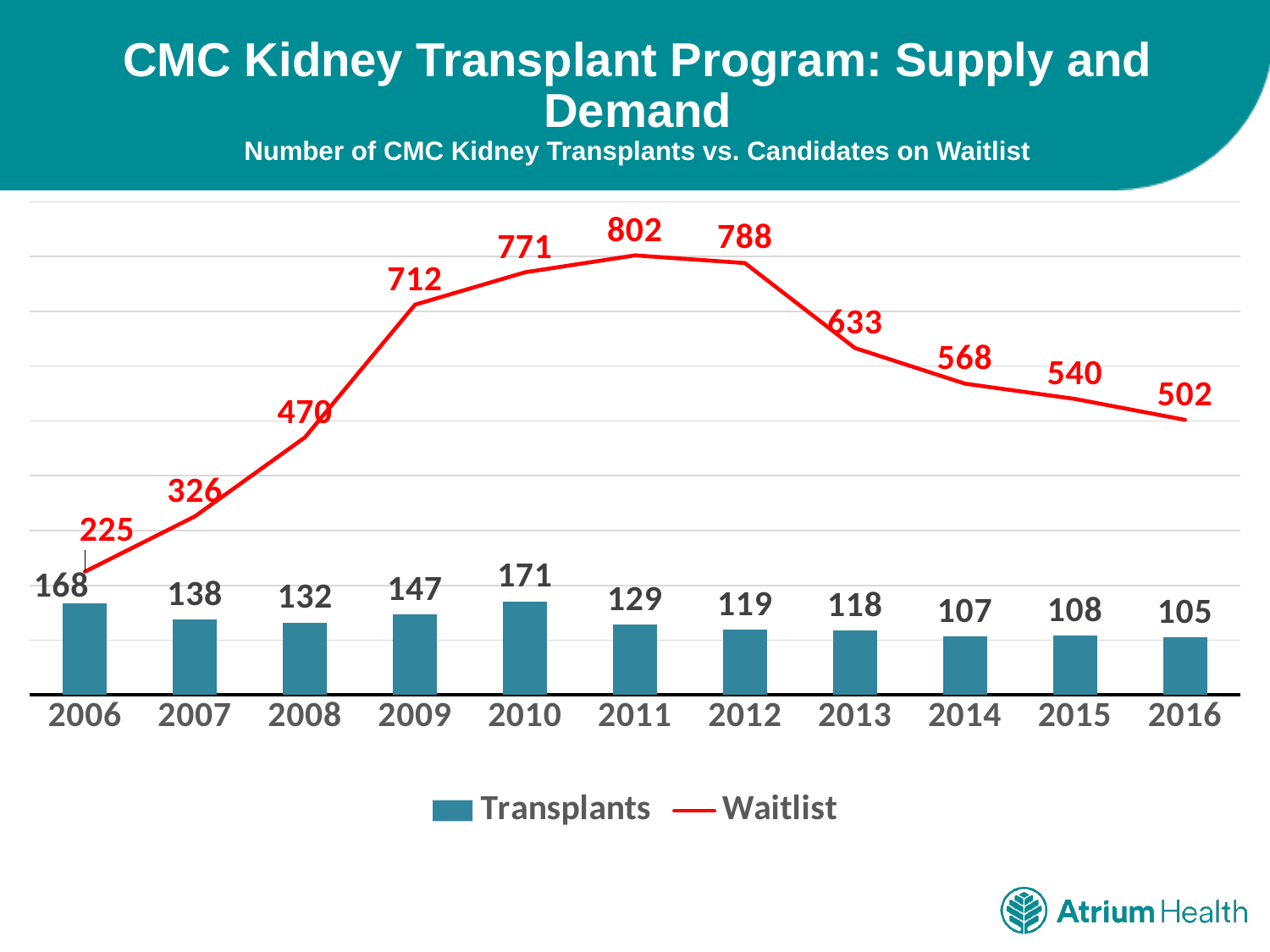
What was the waitlist value in 2016? 502 What colour is the Waitlist line? Red Which year had the lowest waitlist value? 2006 How many candidates were on the waitlist in 2011? 802 How many years are shown on the x axis? 11 How many series does the legend list? 2 How many kidney transplants were performed in 2010? 171 Which is larger, the number of transplants in 2009 or in 2013? 2009 Which year had the highest number of transplants? 2010 What kind of chart is used for the Transplants series? Bar chart What is the difference between the waitlist and transplants in 2011? 673 Does the waitlist rise or fall from 2012 to 2016? Fall